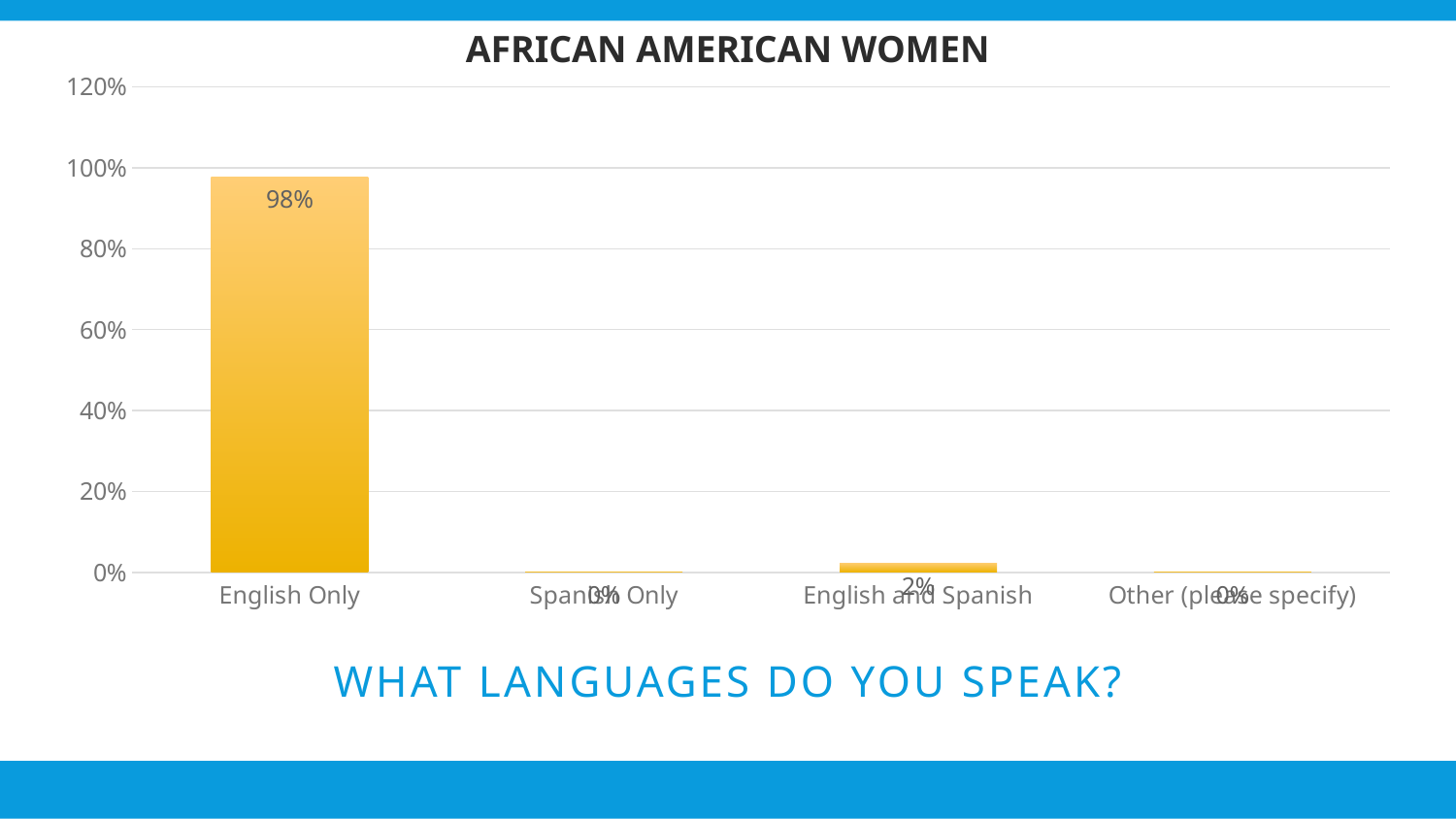
What is the highest value shown on the y axis? 120% What kind of chart is shown on the slide? bar chart What is the value for English and Spanish? 2% How many categories are shown on the x axis? 4 Which is larger, the value for English and Spanish or the value for Spanish Only? English and Spanish Which category has the highest value? English Only Is the value for English Only greater or less than 80%? greater What is the title of the chart? AFRICAN AMERICAN WOMEN What is the value for Other (please specify)? 0% What is the value for English Only? 98% What is the value for Spanish Only? 0% What is the difference between the values for English Only and English and Spanish? 96%